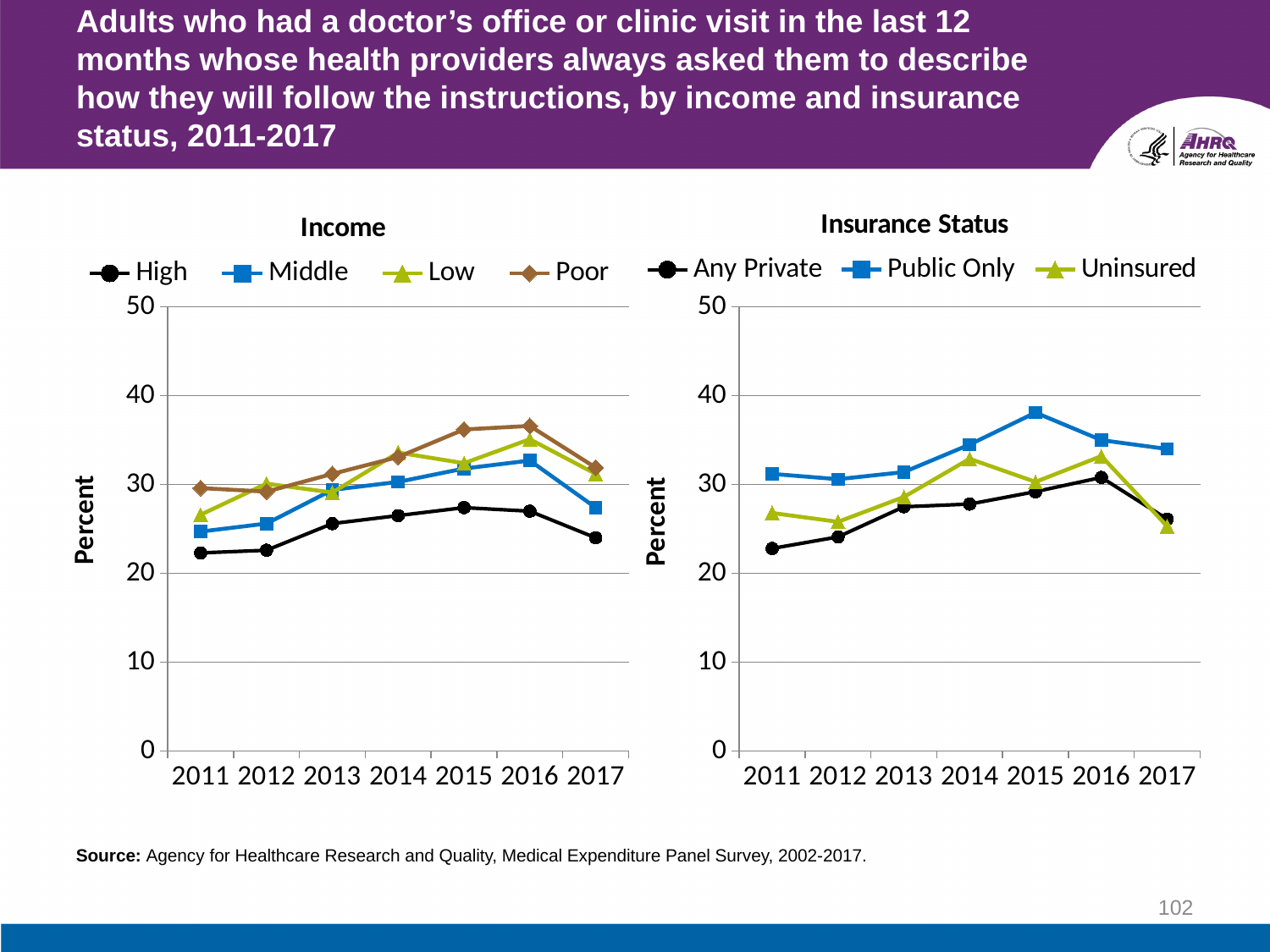
In the Income chart, which series has the lowest value in 2011? High In the Income chart, is the value for High in 2011 greater or less than 30? less In the Insurance Status chart, is the value for Any Private in 2011 greater or less than 30? less In the Income chart, does the High series rise or fall from 2011 to 2015? rise How many series does the legend of the Income chart list? 4 In the Insurance Status chart, which is larger in 2017: Public Only or Any Private? Public Only In the Income chart, is the value for Poor in 2016 greater or less than 30? greater How many series does the legend of the Insurance Status chart list? 3 How many years are shown on the x axis of the Insurance Status chart? 7 What kind of chart is the Income chart? line chart In the Insurance Status chart, which series has the highest value in 2015? Public Only